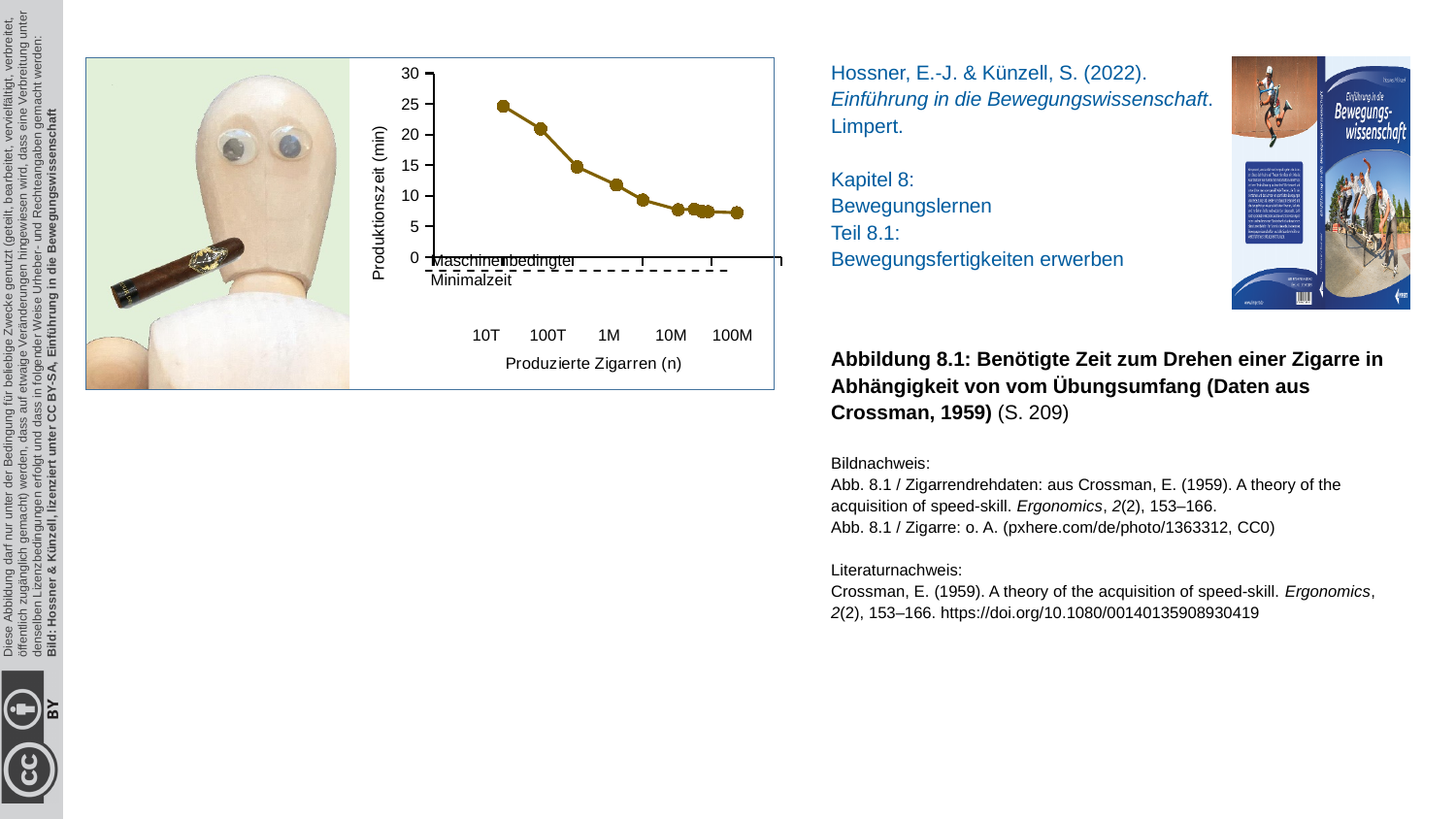
At which x-axis label is the Produktionszeit highest? 10T Is the Produktionszeit at 10T produced cigars greater or less than 20 min? greater What kind of chart is shown on the slide? line chart Is the Produktionszeit at 1M produced cigars greater or less than 20 min? less Do the values of Produktionszeit rise or fall as the number of produced cigars increases along the x axis? fall What does the dashed horizontal line near the bottom of the chart represent? Maschinenbedingte Minimalzeit What is the label of the y axis? Produktionszeit (min) Which has the larger Produktionszeit: 10T or 100M produced cigars? 10T Is the Produktionszeit at 100M produced cigars greater or less than 10 min? less How many labelled tick marks are shown on the x axis? 5